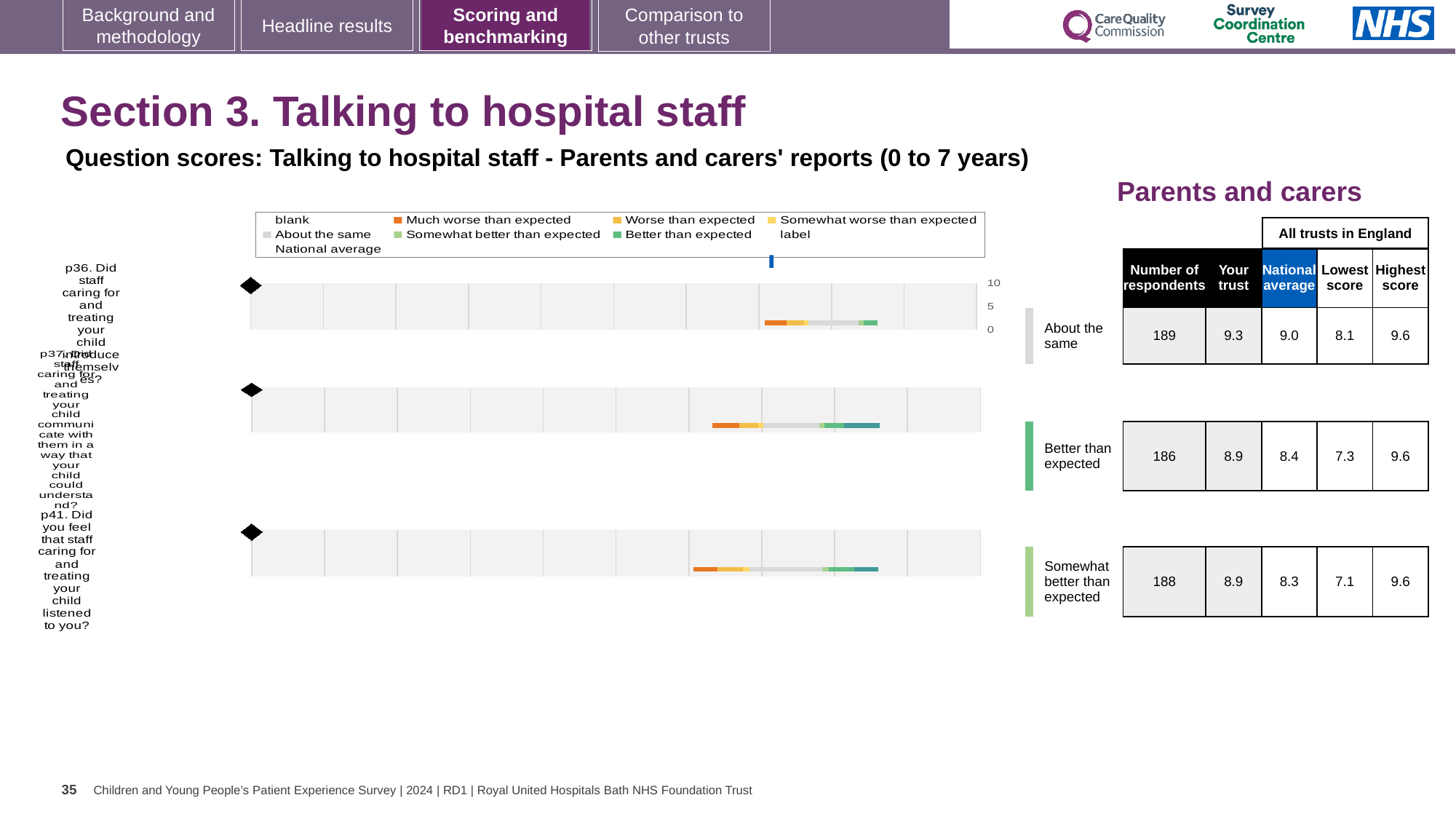
In the table beside the chart, which row has the lowest 'Lowest score' value? Somewhat better than expected How many question categories (bars) are plotted in the chart? 3 What is the highest value shown on the chart's axis? 10 In the table beside the chart, what is the difference between the 'Your trust' score and the national average for the 'Better than expected' row? 0.5 In the table beside the chart, which row has the highest 'Your trust' score? About the same How many entries does the chart's legend list? 9 In the table beside the chart, what is the 'Your trust' score for the first row (About the same)? 9.3 What kind of chart is shown on the slide? bar chart Which legend entry is shown in orange? Much worse than expected In the table beside the chart, what is the number of respondents for the 'Better than expected' row? 186 In the table beside the chart, what is the national average for the 'Somewhat better than expected' row? 8.3 In the table beside the chart, is the 'Your trust' score for the 'About the same' row larger or smaller than its national average? larger